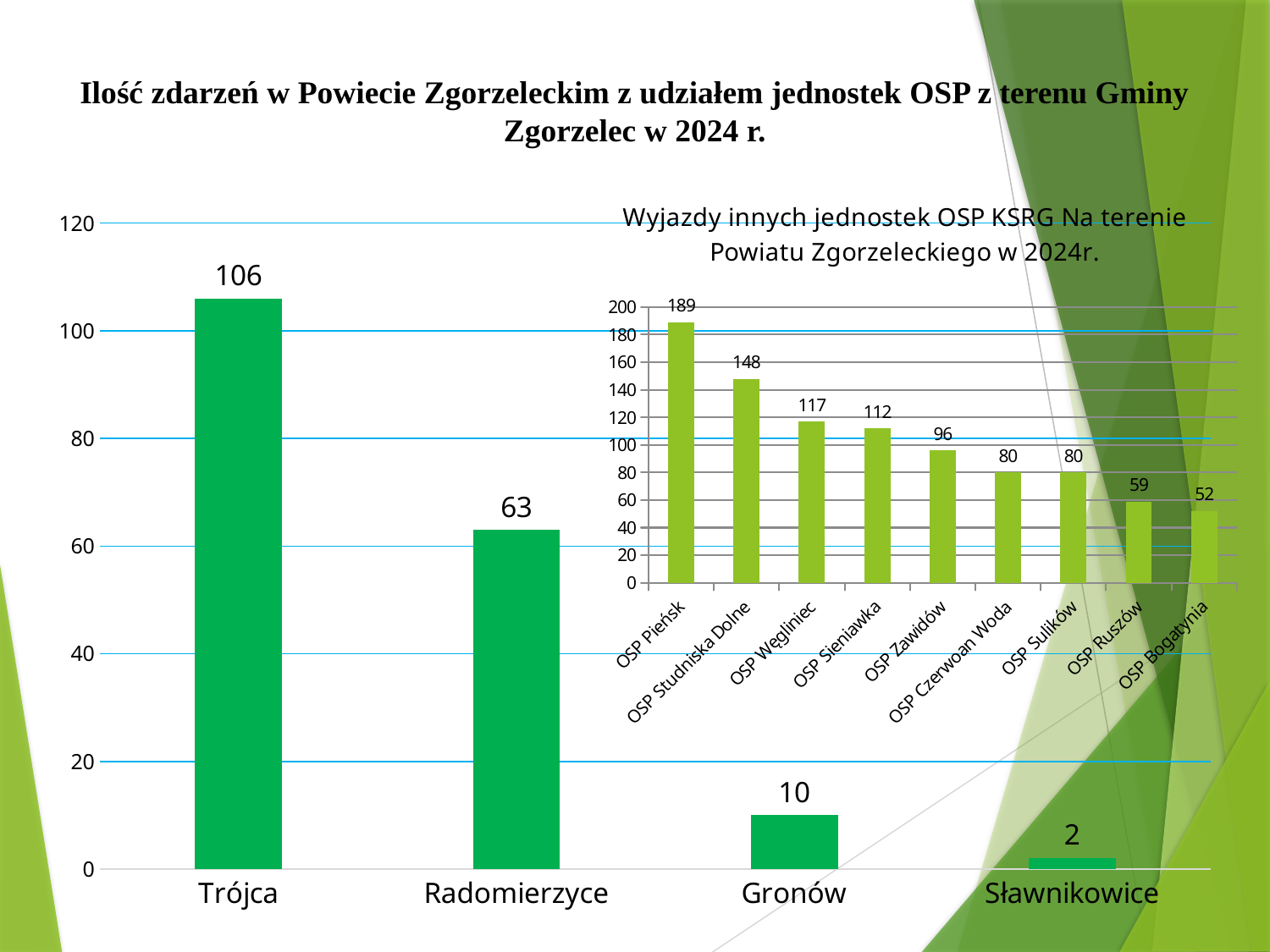
In the inset chart titled 'Wyjazdy innych jednostek OSP KSRG Na terenie Powiatu Zgorzeleckiego w 2024r.', what is the value for OSP Zawidów? 96 In the inset chart titled 'Wyjazdy innych jednostek OSP KSRG Na terenie Powiatu Zgorzeleckiego w 2024r.', which category has the lowest value? OSP Bogatynia In the large chart on the left, what is the value for Trójca? 106 In the large chart on the left, what is the difference between the values for Trójca and Radomierzyce? 43 In the inset chart titled 'Wyjazdy innych jednostek OSP KSRG Na terenie Powiatu Zgorzeleckiego w 2024r.', which is larger, the value for OSP Węgliniec or OSP Sieniawka? OSP Węgliniec In the large chart on the left, do the values rise or fall from left to right? fall In the large chart on the left, what is the value for Radomierzyce? 63 In the large chart on the left, what kind of chart is it? bar chart In the inset chart titled 'Wyjazdy innych jednostek OSP KSRG Na terenie Powiatu Zgorzeleckiego w 2024r.', what is the value for OSP Pieńsk? 189 In the inset chart titled 'Wyjazdy innych jednostek OSP KSRG Na terenie Powiatu Zgorzeleckiego w 2024r.', how many categories are shown? 9 In the large chart on the left, how many categories are shown? 4 In the large chart on the left, which category has the lowest value? Sławnikowice